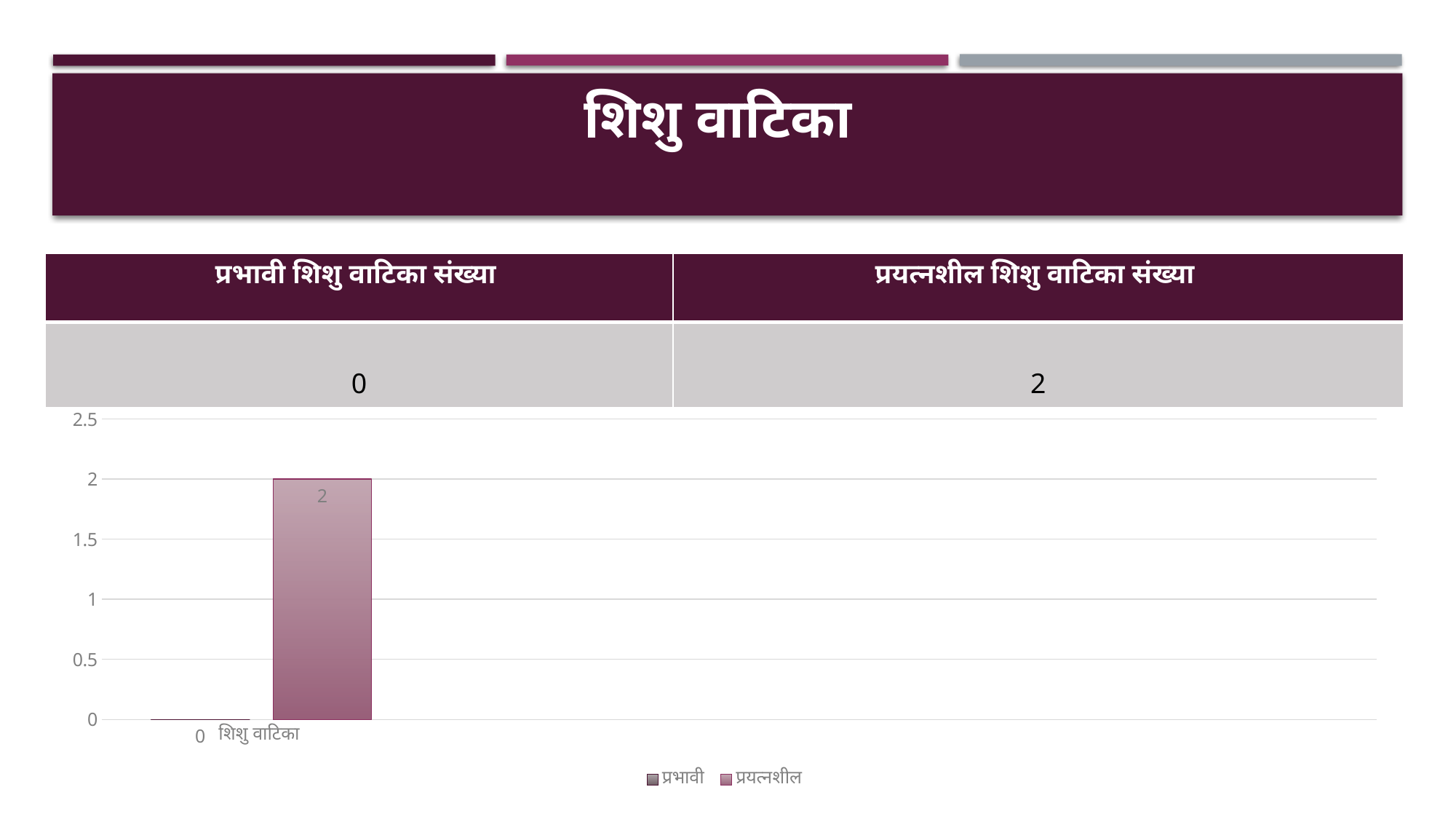
What is the category label on the x axis of the chart? शिशु वाटिका What kind of chart is shown on the slide? bar chart What is the highest value shown on the y axis of the chart? 2.5 Which series has the higher value, प्रभावी or प्रयत्नशील? प्रयत्नशील How many categories are shown on the x axis of the chart? 1 What is the value for प्रभावी in the chart? 0 Is the value for प्रयत्नशील greater or less than 1? greater How many series does the legend list? 2 What is the value for प्रयत्नशील in the chart? 2 What is the difference between the प्रयत्नशील value and the प्रभावी value? 2